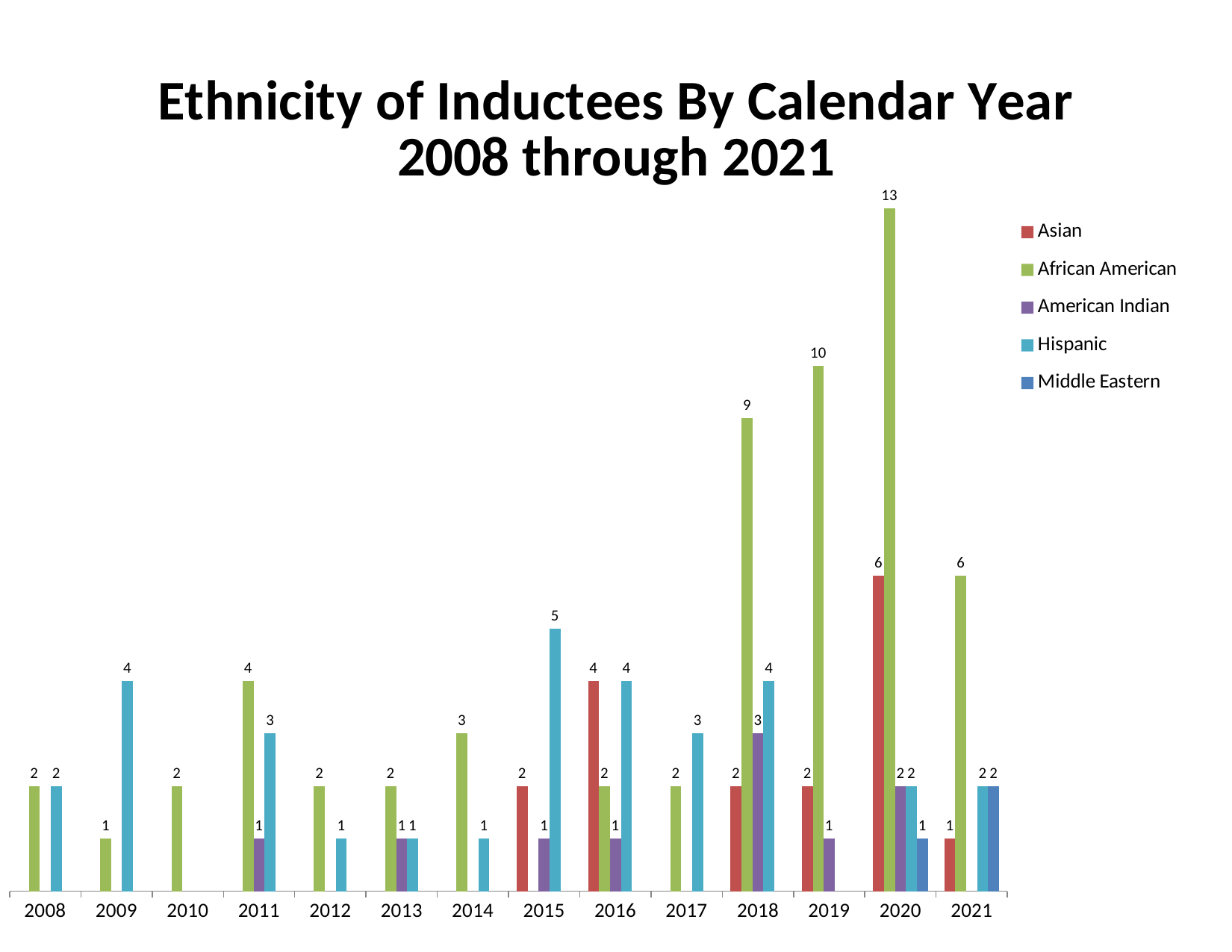
Which is larger in 2018, the African American value or the Hispanic value? African American What is the value for Asian inductees in 2016? 4 What is the value for African American inductees in 2020? 13 What is the difference between the African American values in 2020 and 2019? 3 What is the value for Middle Eastern inductees in 2021? 2 What type of chart is shown on the slide? Bar chart What is the value for Hispanic inductees in 2015? 5 In which year is the Hispanic value highest? 2015 How many series does the legend list? 5 What is the title of the chart? Ethnicity of Inductees By Calendar Year 2008 through 2021 In which year is the African American value highest? 2020 How many calendar years are shown on the x axis? 14